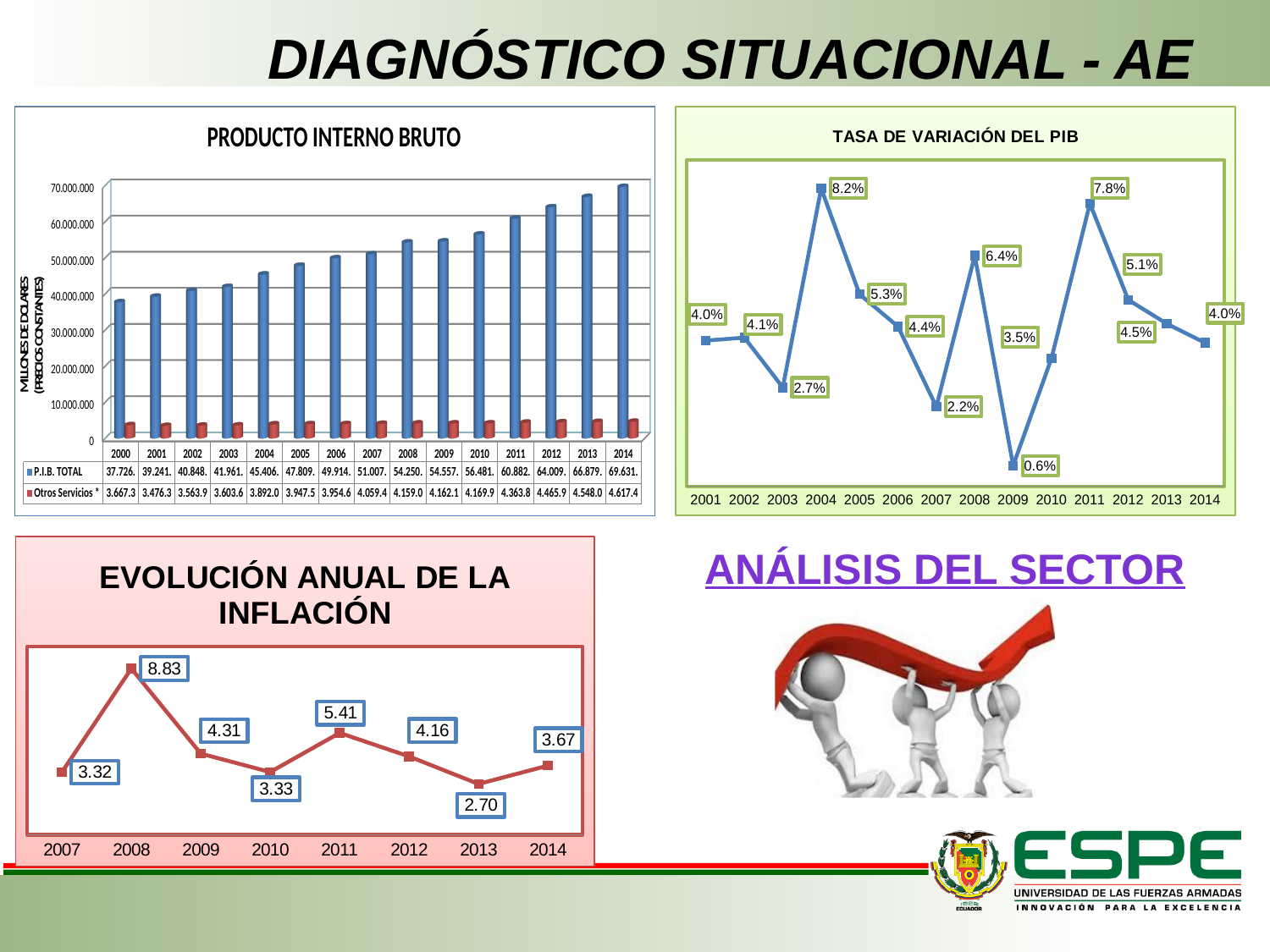
In the 'TASA DE VARIACIÓN DEL PIB' chart, which year has the lowest value? 2009 In the 'EVOLUCIÓN ANUAL DE LA INFLACIÓN' chart, which year has the highest value? 2008 In the 'EVOLUCIÓN ANUAL DE LA INFLACIÓN' chart, what is the difference between the values for 2008 and 2013? 6.13 In the 'PRODUCTO INTERNO BRUTO' chart, do the P.I.B. TOTAL values rise or fall from 2000 to 2014? rise In the 'EVOLUCIÓN ANUAL DE LA INFLACIÓN' chart, which is larger, the value for 2009 or the value for 2012? 2009 In the 'TASA DE VARIACIÓN DEL PIB' chart, what is the value for 2004? 8.2% What kind of chart is 'PRODUCTO INTERNO BRUTO'? bar chart In the 'PRODUCTO INTERNO BRUTO' chart, is the P.I.B. TOTAL value for 2014 greater or less than 60.000.000? greater In the 'TASA DE VARIACIÓN DEL PIB' chart, what is the difference between the values for 2011 and 2012? 2.7% In the 'TASA DE VARIACIÓN DEL PIB' chart, how many years are plotted? 14 How many series does the legend of the 'PRODUCTO INTERNO BRUTO' chart list? 2 In the 'EVOLUCIÓN ANUAL DE LA INFLACIÓN' chart, what is the value for 2011? 5.41